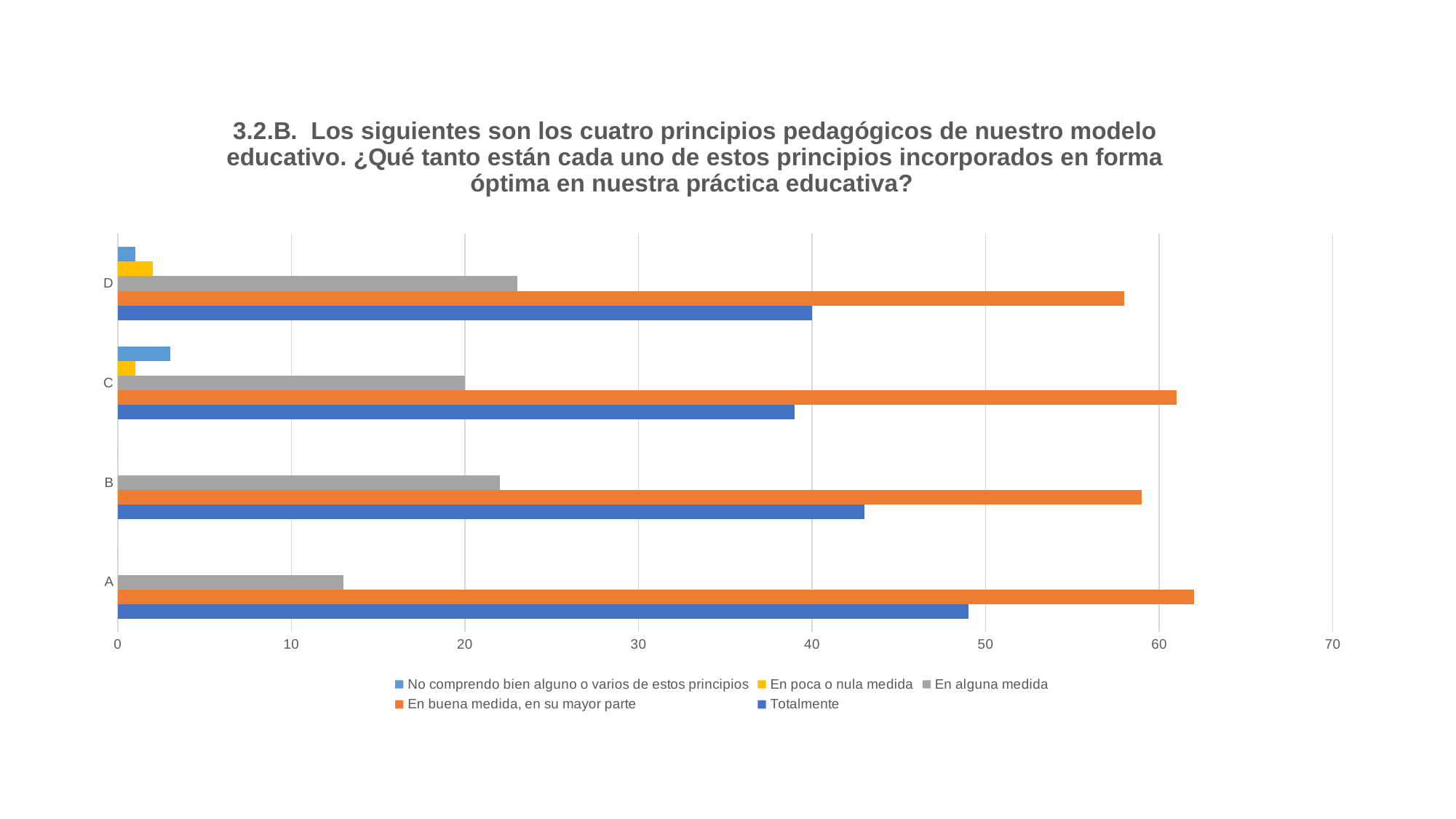
Is the 'En buena medida, en su mayor parte' value for category D greater or less than 60? less Is the 'Totalmente' value for category A greater or less than 40? greater What colour represents the 'Totalmente' series in the legend? blue What kind of chart is shown on the slide? bar chart Which is larger: the 'Totalmente' value for category A or for category B? A How many categories are shown on the vertical axis of the chart? 4 Is the 'En alguna medida' value for category B greater or less than 30? less Which category has the highest value for the 'Totalmente' series? A How many series does the legend list? 5 For category A, which is larger: the 'Totalmente' value or the 'En buena medida, en su mayor parte' value? En buena medida, en su mayor parte Which category has the lowest value for the 'En alguna medida' series? A